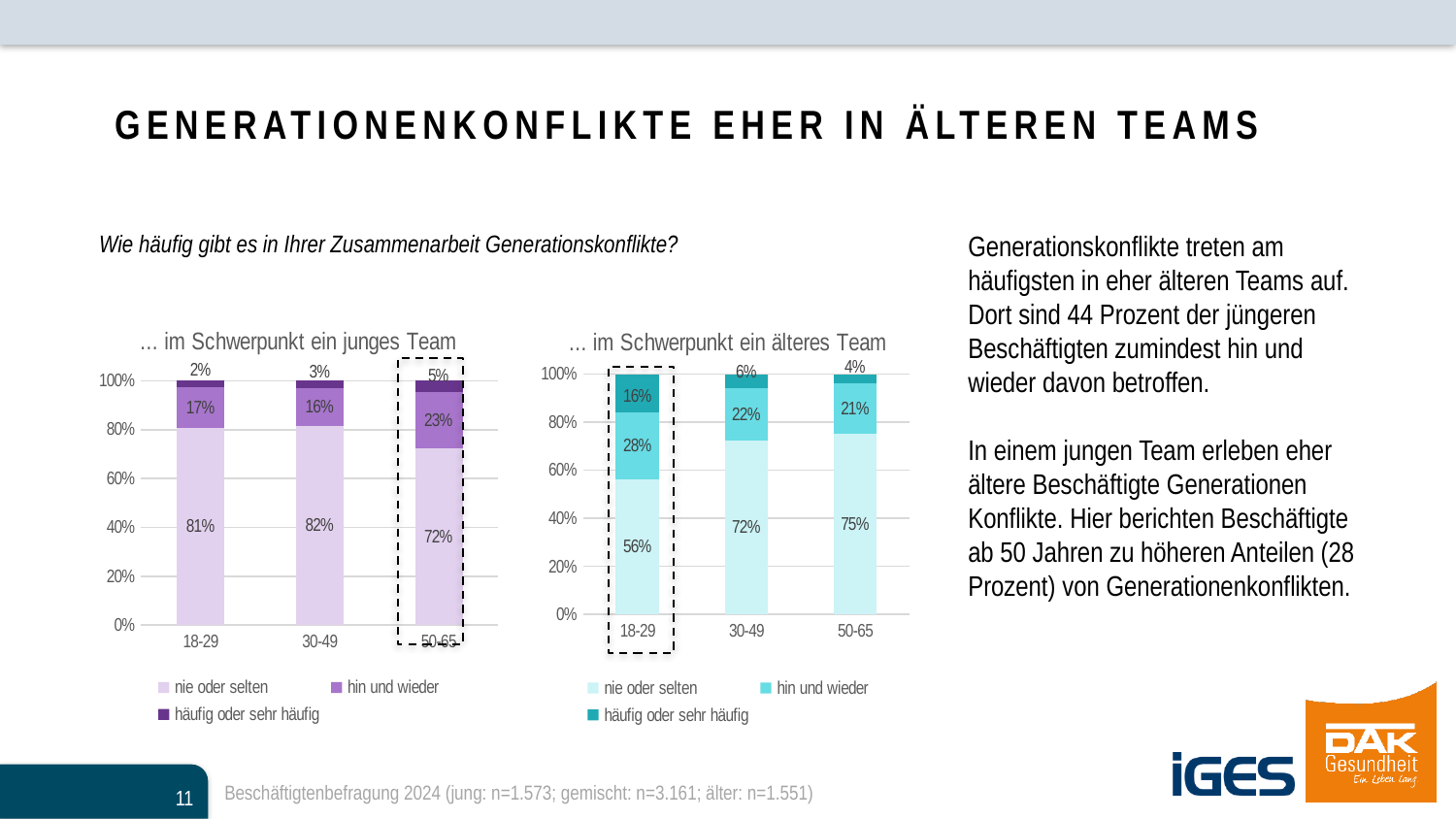
In the chart '… im Schwerpunkt ein älteres Team', what is the value for 'häufig oder sehr häufig' in the 18-29 group? 16% In the chart '… im Schwerpunkt ein älteres Team', what is the difference between the 'nie oder selten' values for 50-65 and 18-29? 19 percentage points In the chart '… im Schwerpunkt ein älteres Team', does the 'häufig oder sehr häufig' value rise or fall from 18-29 to 50-65? fall In the chart '… im Schwerpunkt ein junges Team', is the 'nie oder selten' value for 30-49 larger or smaller than the 'nie oder selten' value for 50-65? larger In the chart '… im Schwerpunkt ein älteres Team', what is the value for 'nie oder selten' in the 50-65 group? 75% In the chart '… im Schwerpunkt ein junges Team', what is the value for 'hin und wieder' in the 50-65 group? 23% In the chart '… im Schwerpunkt ein älteres Team', which age group has the lowest value for 'nie oder selten'? 18-29 How many series does the legend of the chart '… im Schwerpunkt ein älteres Team' list? 3 How many age groups are shown on the x axis of the chart '… im Schwerpunkt ein junges Team'? 3 In the chart '… im Schwerpunkt ein junges Team', which age group has the highest value for 'hin und wieder'? 50-65 In the chart '… im Schwerpunkt ein junges Team', what is the value for 'nie oder selten' in the 18-29 group? 81% What type of chart is '… im Schwerpunkt ein älteres Team'? Stacked bar chart